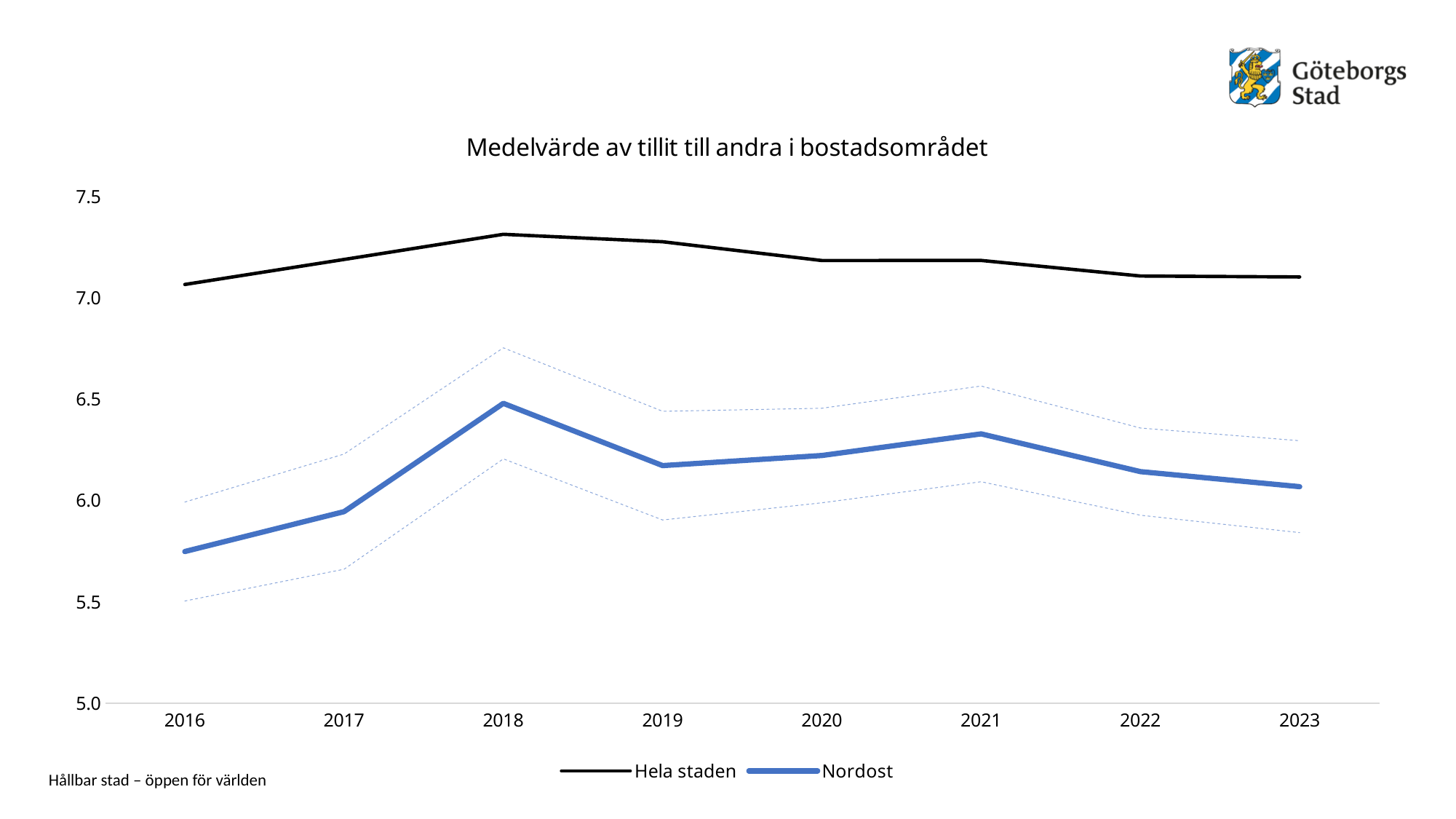
Is the value for Nordost in 2016 greater or less than 6.0? less What kind of chart is shown on the slide? line chart How many series does the legend list? 2 How many years are shown on the x axis? 8 In which year does the Hela staden series reach its highest value? 2018 In which year does the Nordost series reach its highest value? 2018 Which series has the larger value in 2018, Hela staden or Nordost? Hela staden Does the Nordost series rise or fall from 2021 to 2023? fall What is the title of the chart? Medelvärde av tillit till andra i bostadsområdet In which year does the Nordost series have its lowest value? 2016 Is the value for Nordost in 2021 greater or less than 6.0? greater Is the value for Hela staden in 2016 greater or less than 7.0? greater